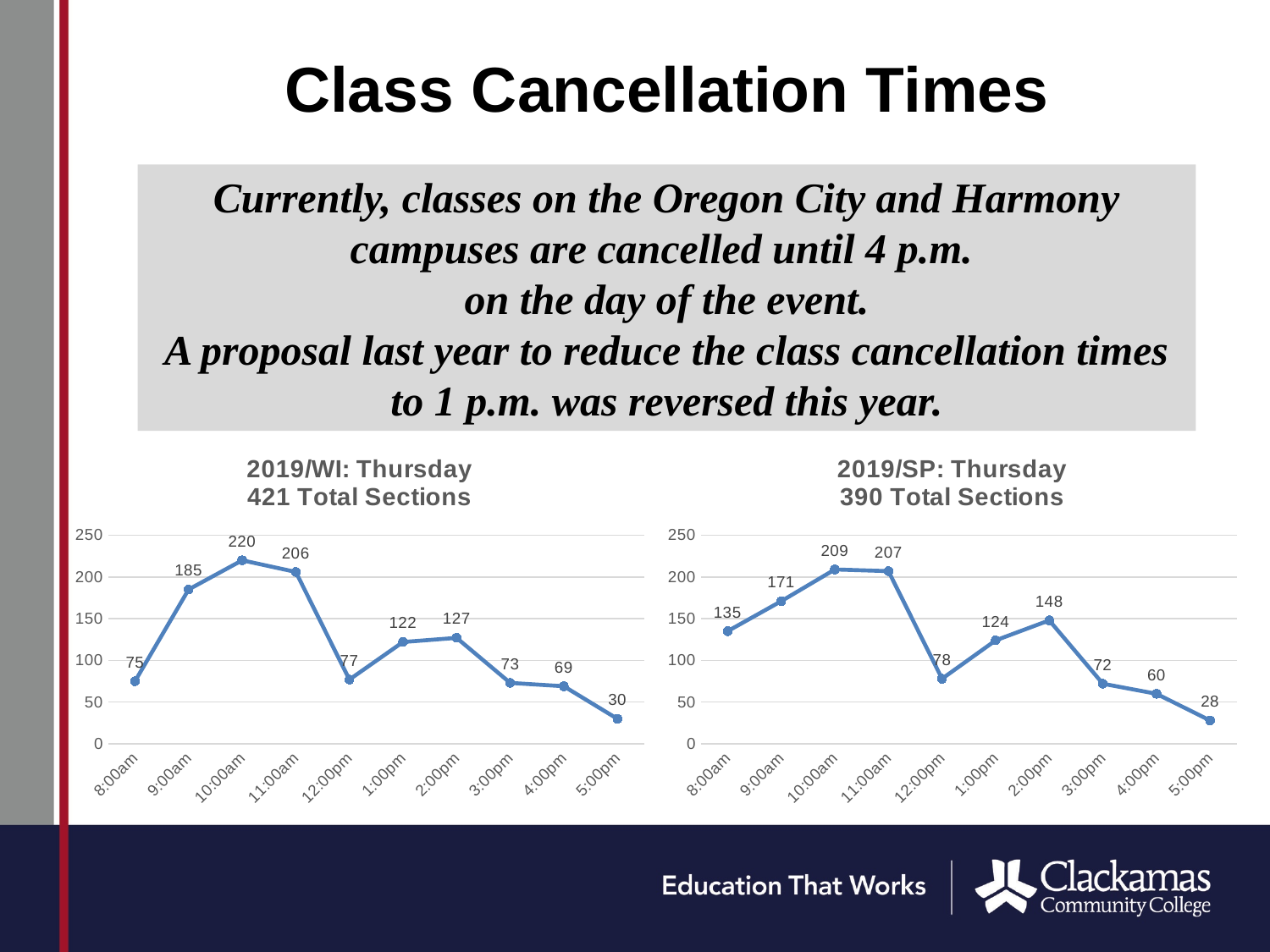
In the 2019/SP: Thursday chart, which time has the highest value? 10:00am In the 2019/WI: Thursday chart, what is the difference between the values at 10:00am and 12:00pm? 143 In the 2019/SP: Thursday chart, what is the difference between the values at 8:00am and 9:00am? 36 In the 2019/WI: Thursday chart, which is larger, the value at 1:00pm or the value at 2:00pm? 2:00pm How many time points are plotted in the 2019/WI: Thursday chart? 10 In the 2019/SP: Thursday chart, what is the value at 2:00pm? 148 What type of chart is the 2019/SP: Thursday chart? line chart In the 2019/WI: Thursday chart, what is the value at 10:00am? 220 In the 2019/WI: Thursday chart, which time has the lowest value? 5:00pm In the 2019/SP: Thursday chart, is the value at 11:00am greater or less than 200? greater In the 2019/WI: Thursday chart, do the values rise or fall from 2:00pm to 5:00pm? fall According to its title, how many total sections does the 2019/SP: Thursday chart cover? 390 Total Sections